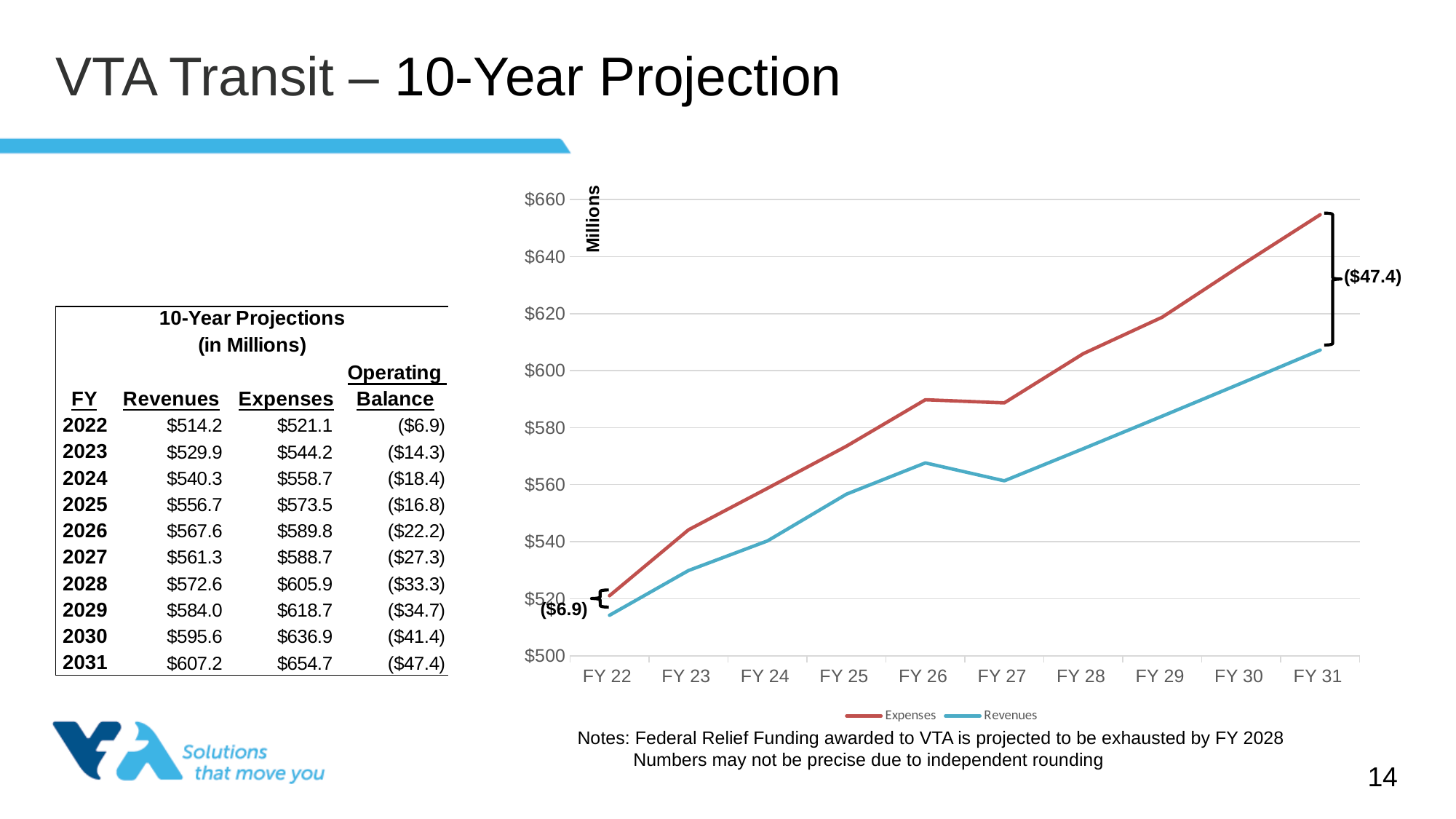
Is the Expenses value for FY 27 greater or less than $580? greater What gap between Expenses and Revenues is labelled on the chart at FY 31? ($47.4) Which fiscal year has the highest Expenses value? FY 31 How many fiscal years are plotted along the x axis of the chart? 10 In FY 31, which series is higher, Expenses or Revenues? Expenses What gap between Expenses and Revenues is labelled on the chart at FY 22? ($6.9) How many series does the chart's legend list? 2 Is the Revenues value for FY 22 greater or less than $520? less Do Expenses rise or fall overall from FY 22 to FY 31? rise What type of chart is shown on the slide? line chart Which colour is used for the Expenses line in the chart? red Is the Expenses value for FY 31 greater or less than $640? greater